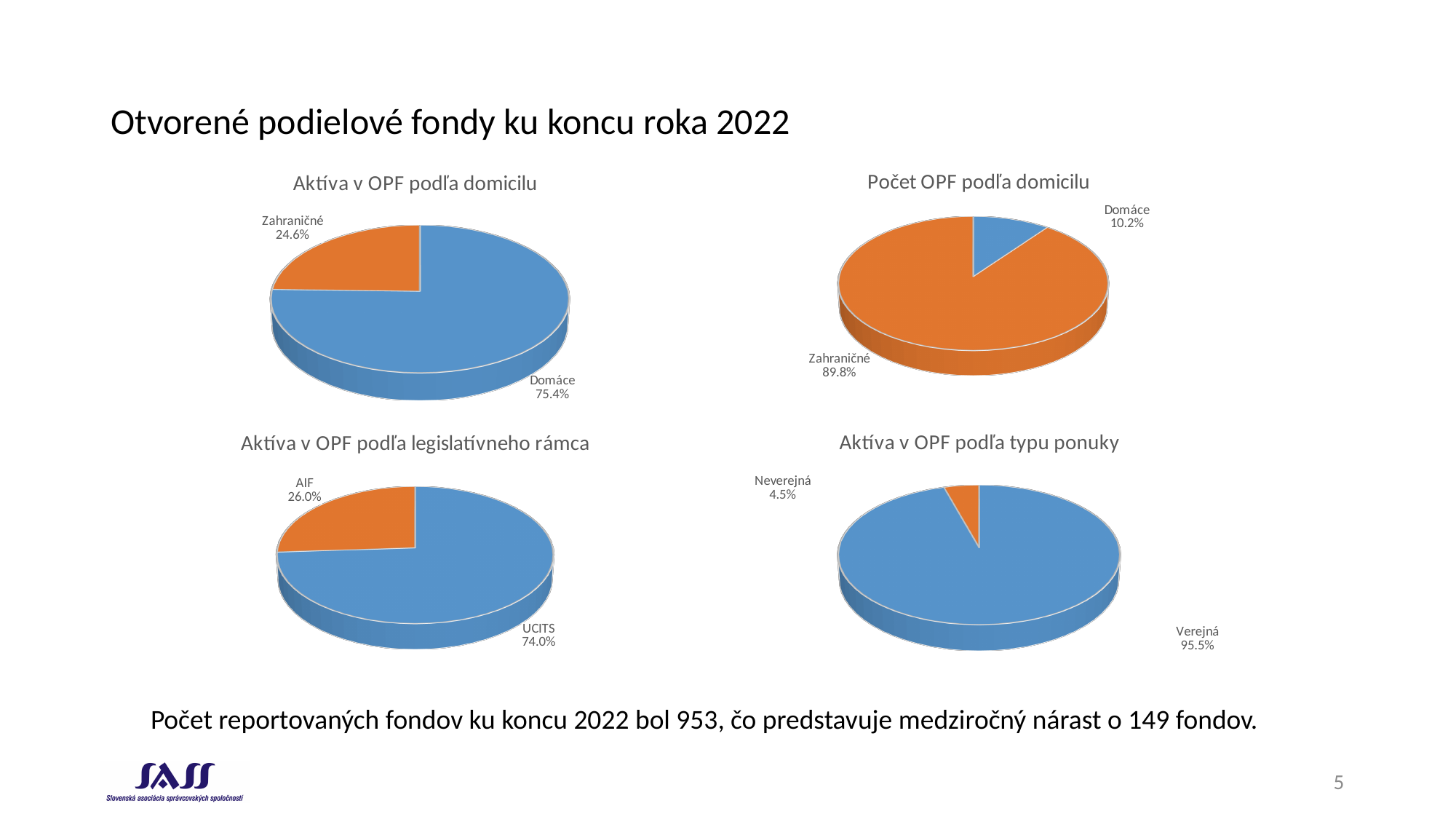
In the chart titled 'Počet OPF podľa domicilu', what share does Domáce have? 10.2% In the chart titled 'Aktíva v OPF podľa domicilu', what share does Domáce have? 75.4% In the chart titled 'Aktíva v OPF podľa legislatívneho rámca', what share does AIF have? 26.0% In the chart titled 'Aktíva v OPF podľa legislatívneho rámca', which category has the smallest slice? AIF What kind of chart is 'Aktíva v OPF podľa typu ponuky'? Pie chart In the chart titled 'Aktíva v OPF podľa domicilu', what share does Zahraničné have? 24.6% In the chart titled 'Aktíva v OPF podľa typu ponuky', what share does Verejná have? 95.5% In the chart titled 'Počet OPF podľa domicilu', which category has the largest slice? Zahraničné In the chart titled 'Aktíva v OPF podľa domicilu', what is the difference between the Domáce and Zahraničné shares? 50.8% How many slices does the chart titled 'Aktíva v OPF podľa legislatívneho rámca' have? 2 In the chart titled 'Aktíva v OPF podľa typu ponuky', what share does Neverejná have? 4.5% In the chart titled 'Počet OPF podľa domicilu', which is larger, Domáce or Zahraničné? Zahraničné